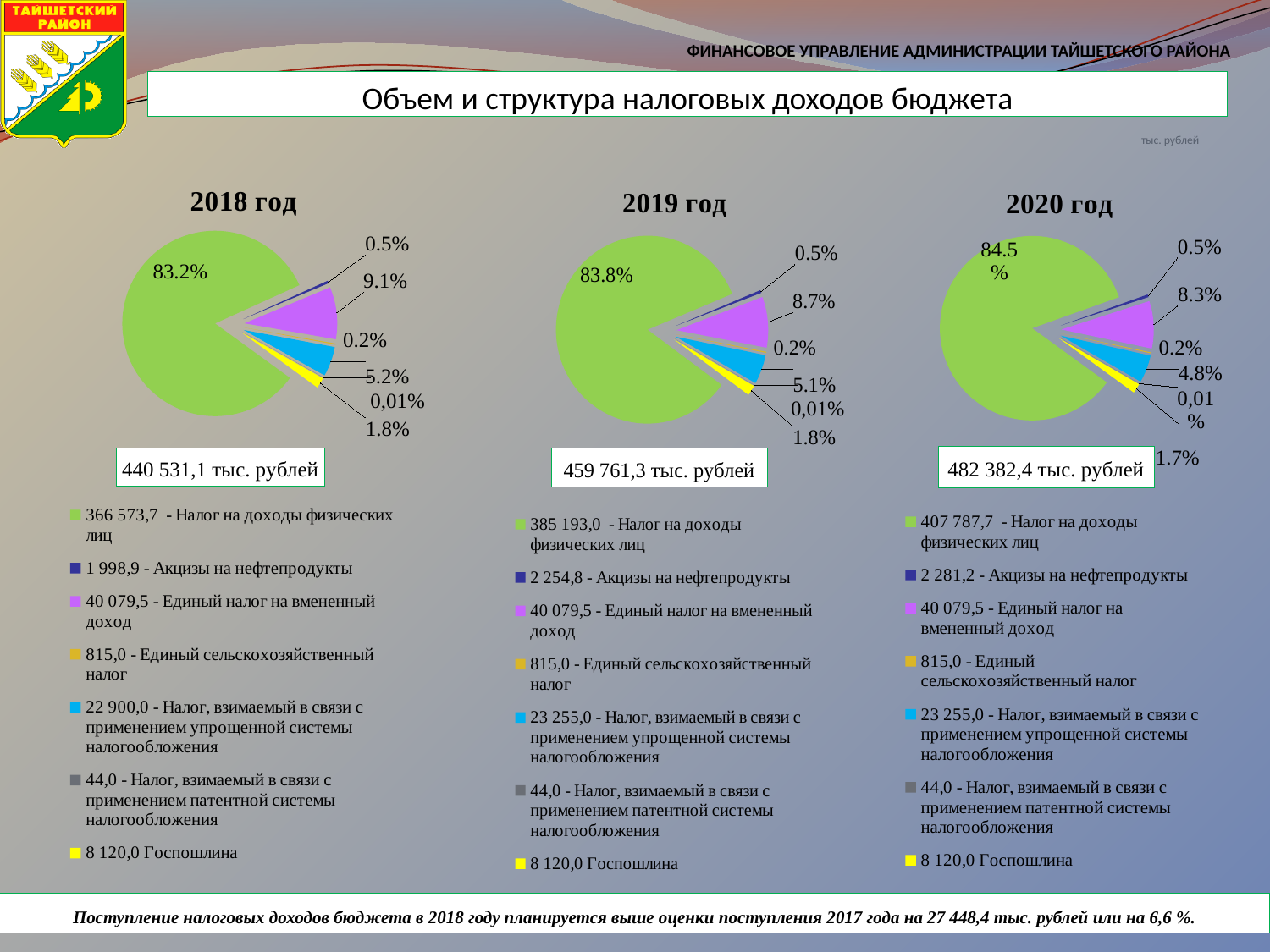
In the 2020 год chart, which category has the largest slice? Налог на доходы физических лиц What kind of chart is used for the 2018 год data? pie chart In the 2019 год chart, what share of the pie is Единый налог на вмененный доход? 8.7% How many categories does the legend of the 2019 год chart list? 7 In the 2020 год chart, what share of the pie is Налог, взимаемый в связи с применением упрощенной системы налогообложения? 4.8% In the 2018 год chart, what share of the pie is Налог на доходы физических лиц? 83.2% In the 2020 год chart, what is the difference in percentage points between the Госпошлина slice (1.7%) and the Единый сельскохозяйственный налог slice (0.2%)? 1.5 Across the 2018, 2019 and 2020 charts, does the share of Налог на доходы физических лиц rise or fall? rise In the 2020 год chart legend, what value is given for Налог на доходы физических лиц? 407 787,7 In the 2018 год chart, which slice is larger: Единый налог на вмененный доход or Налог, взимаемый в связи с применением упрощенной системы налогообложения? Единый налог на вмененный доход In the 2018 год chart, which category has the smallest slice? Налог, взимаемый в связи с применением патентной системы налогообложения In the 2019 год chart legend, what value is given for Акцизы на нефтепродукты? 2 254,8